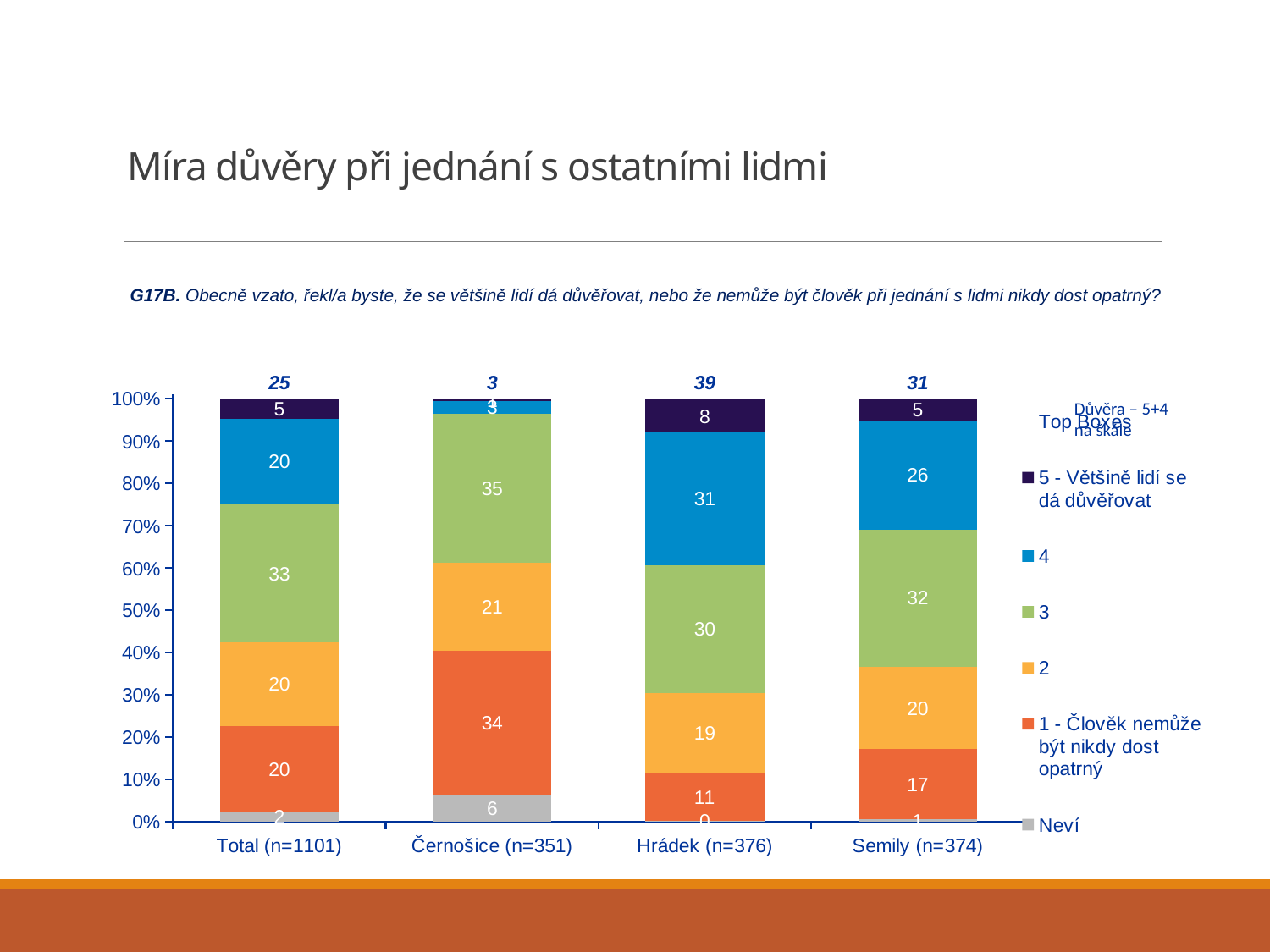
What is the value of series "3" for Semily (n=374)? 32 What is the difference between the series "4" values for Hrádek (n=376) and Total (n=1101)? 11 Which category has the lowest value for series "4"? Černošice (n=351) How many categories are shown on the x axis? 4 Which is larger: the series "4" value for Semily (n=374) or for Total (n=1101)? Semily (n=374) What is the value of series "1 - Člověk nemůže být nikdy dost opatrný" for Černošice (n=351)? 34 What is the value of series "4" for Hrádek (n=376)? 31 How many series does the legend list? 7 Which category has the highest value for series "1 - Člověk nemůže být nikdy dost opatrný"? Černošice (n=351) Which category has the highest Top Boxes value shown above the bars? Hrádek (n=376) What is the Top Boxes value shown above the bar for Hrádek (n=376)? 39 What is the value of series "Neví" for Černošice (n=351)? 6